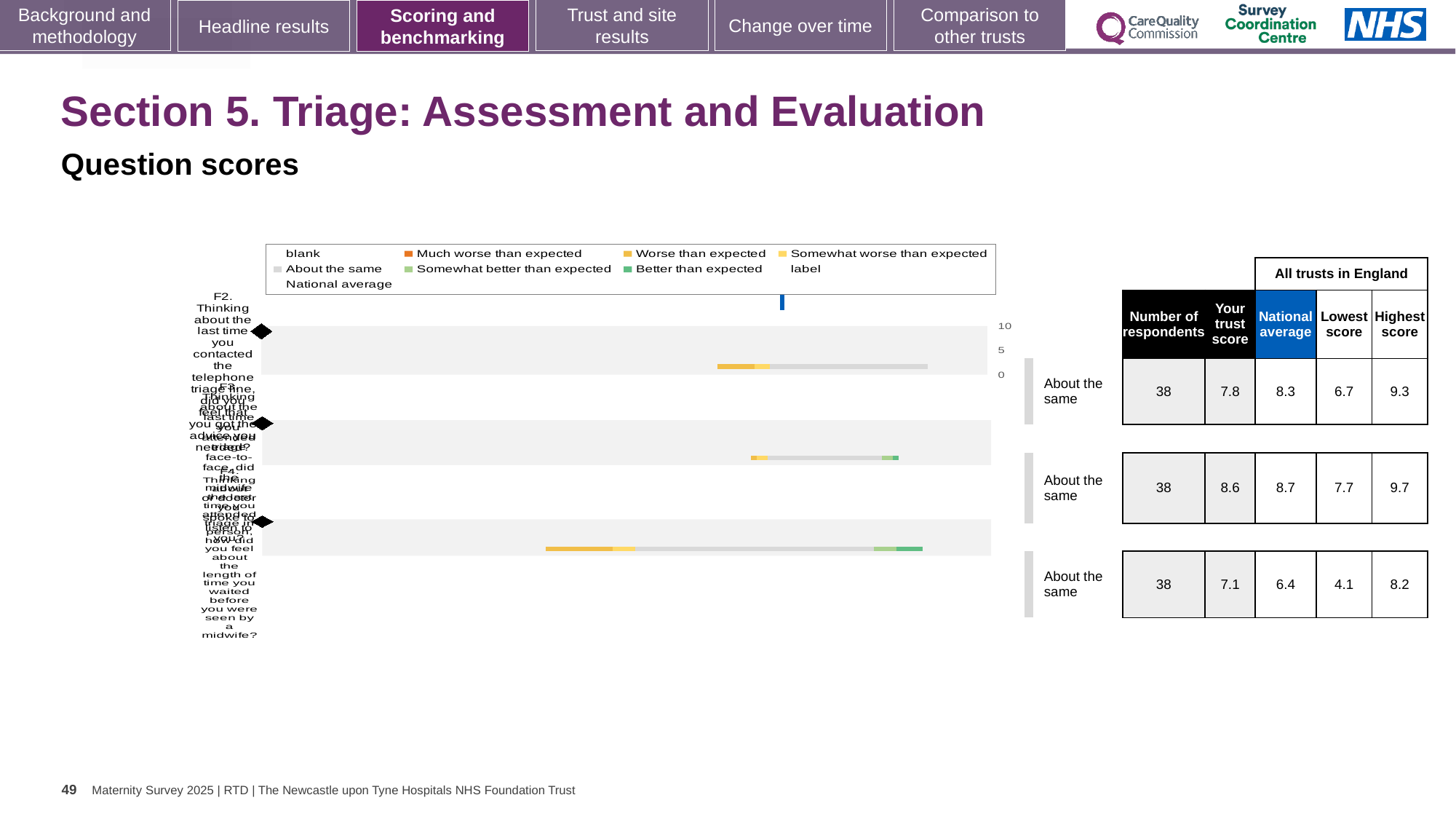
What colour represents 'Much worse than expected' in the chart legend? orange In the table beside the chart, what is the national average for the third row (F4)? 6.4 In the table beside the chart, what is the 'Your trust score' for the first row (F2)? 7.8 In the table beside the chart, how many respondents are listed for the second row (F3)? 38 What is the difference between the highest score and the lowest score for the first row (F2)? 2.6 What colour represents 'Better than expected' in the chart legend? green How many question rows (F2, F3, F4) are plotted in the chart? 3 For the third row (F4), is the trust score or the national average larger? trust score (7.1) Which row in the table beside the chart has the lowest 'Lowest score' value? F4 (4.1) What benchmark category is shown next to each of the three rows of the chart? About the same What kind of chart is shown on the slide? bar chart Which row in the table beside the chart has the highest 'Highest score' value? F3 (9.7)